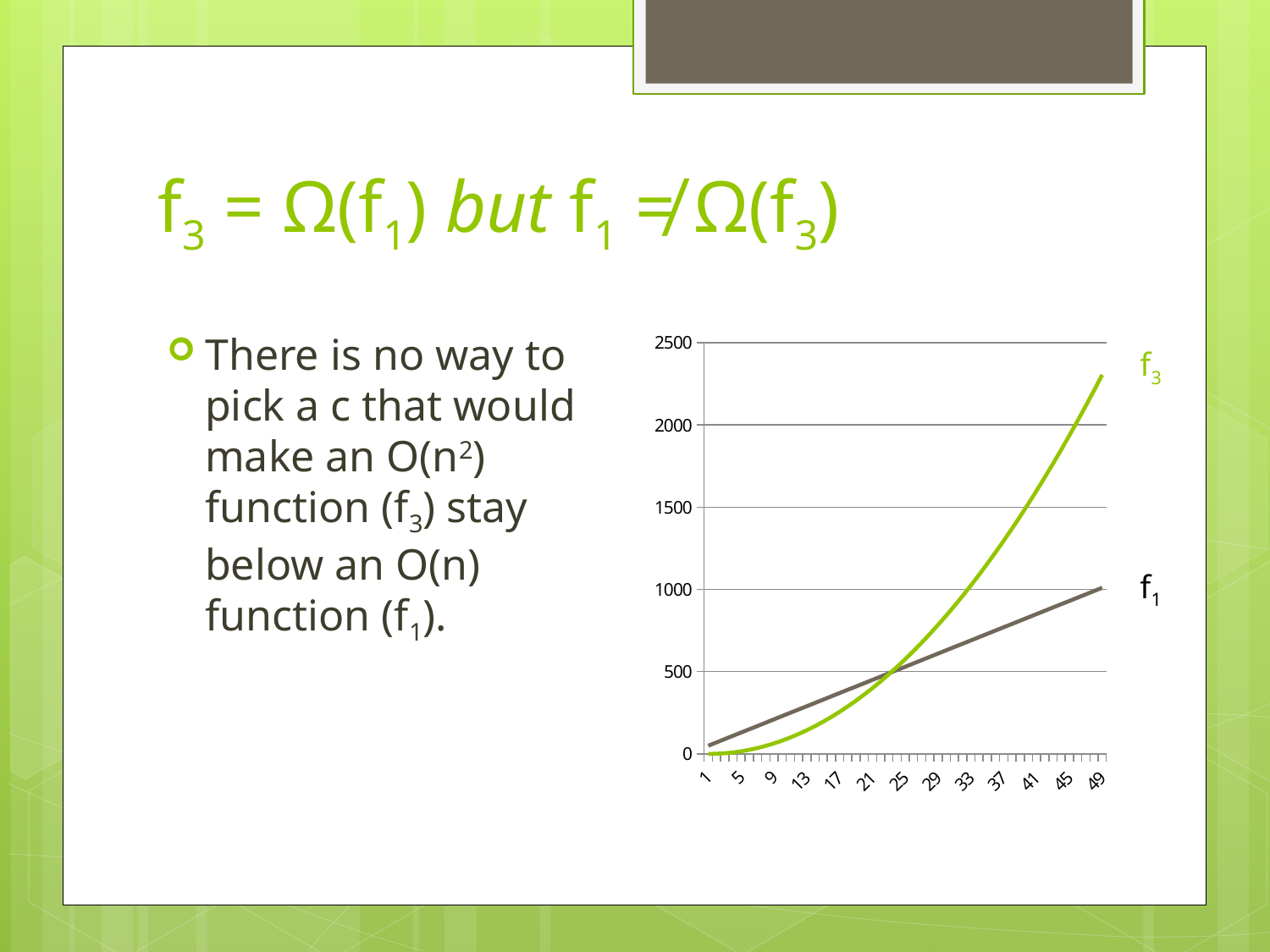
What kind of chart is shown on the slide? line chart What is the highest value labelled on the y axis? 2500 Is the value of f3 at x = 13 greater or less than 500? less Which line is drawn in green, f3 or f1? f3 Do the values of f3 rise or fall as x increases along the x axis? rise Do the values of f1 rise or fall as x increases along the x axis? rise How many lines (series) are plotted on the chart? 2 Is the value of f3 at x = 49 greater or less than 2000? greater Is the value of f1 at x = 49 greater or less than 500? greater What are the labels of the two lines plotted on the chart? f3 and f1 At x = 49, which line has the larger value, f3 or f1? f3 At x = 9, which line has the larger value, f3 or f1? f1